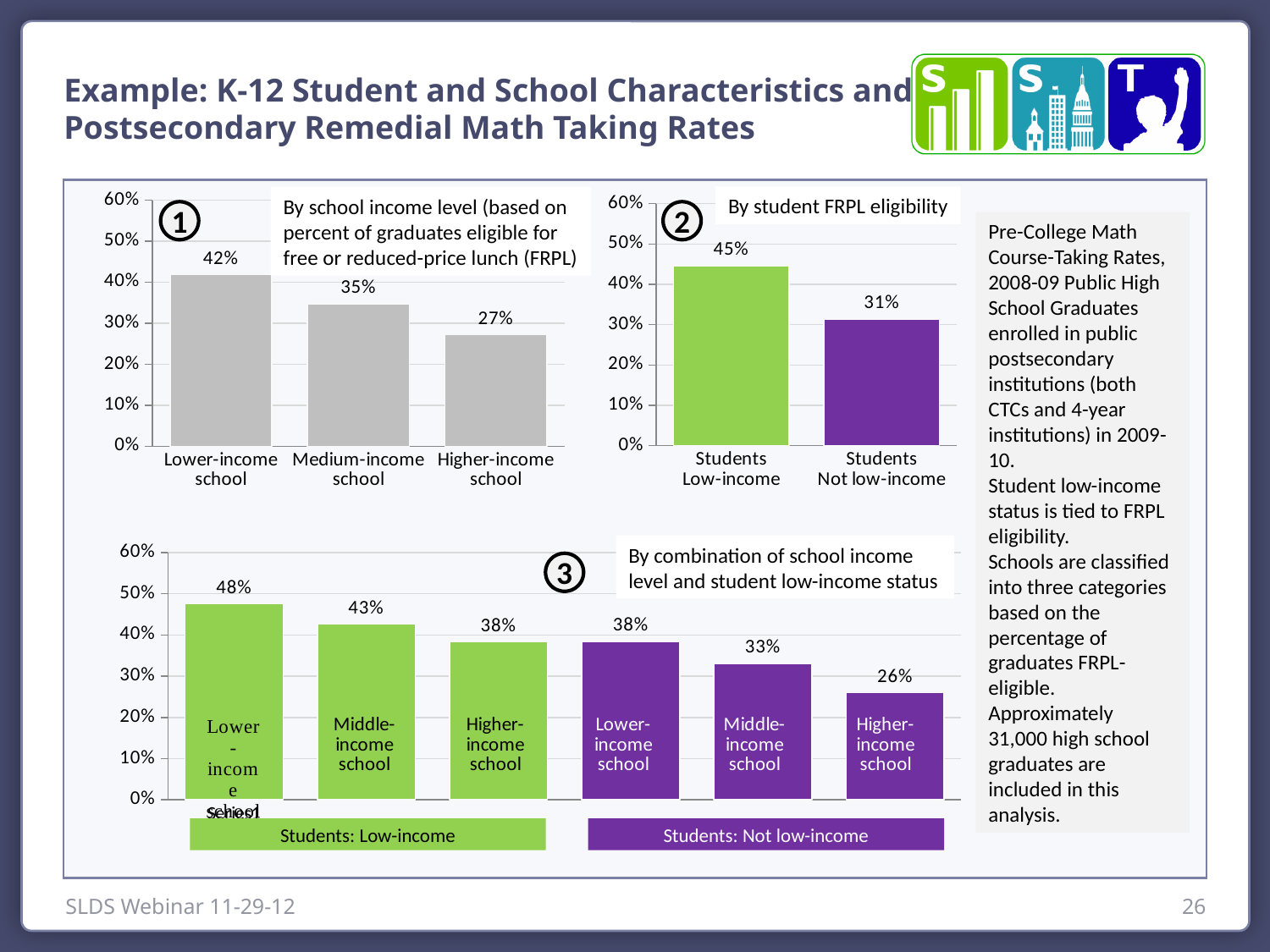
What type of chart is the top-left chart 'By school income level'? bar chart In the chart 'By school income level' (top left), what is the difference between Lower-income school and Higher-income school? 15% In the chart 'By student FRPL eligibility' (top right), what is the value for Students Not low-income? 31% In the chart 'By school income level' (top left), what is the value for Medium-income school? 35% In the bottom chart 'By combination of school income level and student low-income status', what is the value for Lower-income school among Students: Low-income? 48% In the bottom chart 'By combination of school income level and student low-income status', what is the value for Higher-income school among Students: Not low-income? 26% In the chart 'By school income level' (top left), how many bars are plotted? 3 In the chart 'By student FRPL eligibility' (top right), what is the difference between Students Low-income and Students Not low-income? 14% In the bottom chart 'By combination of school income level and student low-income status', which bar has the lowest value? Higher-income school, Students: Not low-income In the chart 'By student FRPL eligibility' (top right), which is larger, Students Low-income or Students Not low-income? Students Low-income In the chart 'By school income level' (top left), which category has the highest value? Lower-income school In the bottom chart 'By combination of school income level and student low-income status', do the values rise or fall from Lower-income school to Higher-income school within the Students: Low-income group? fall